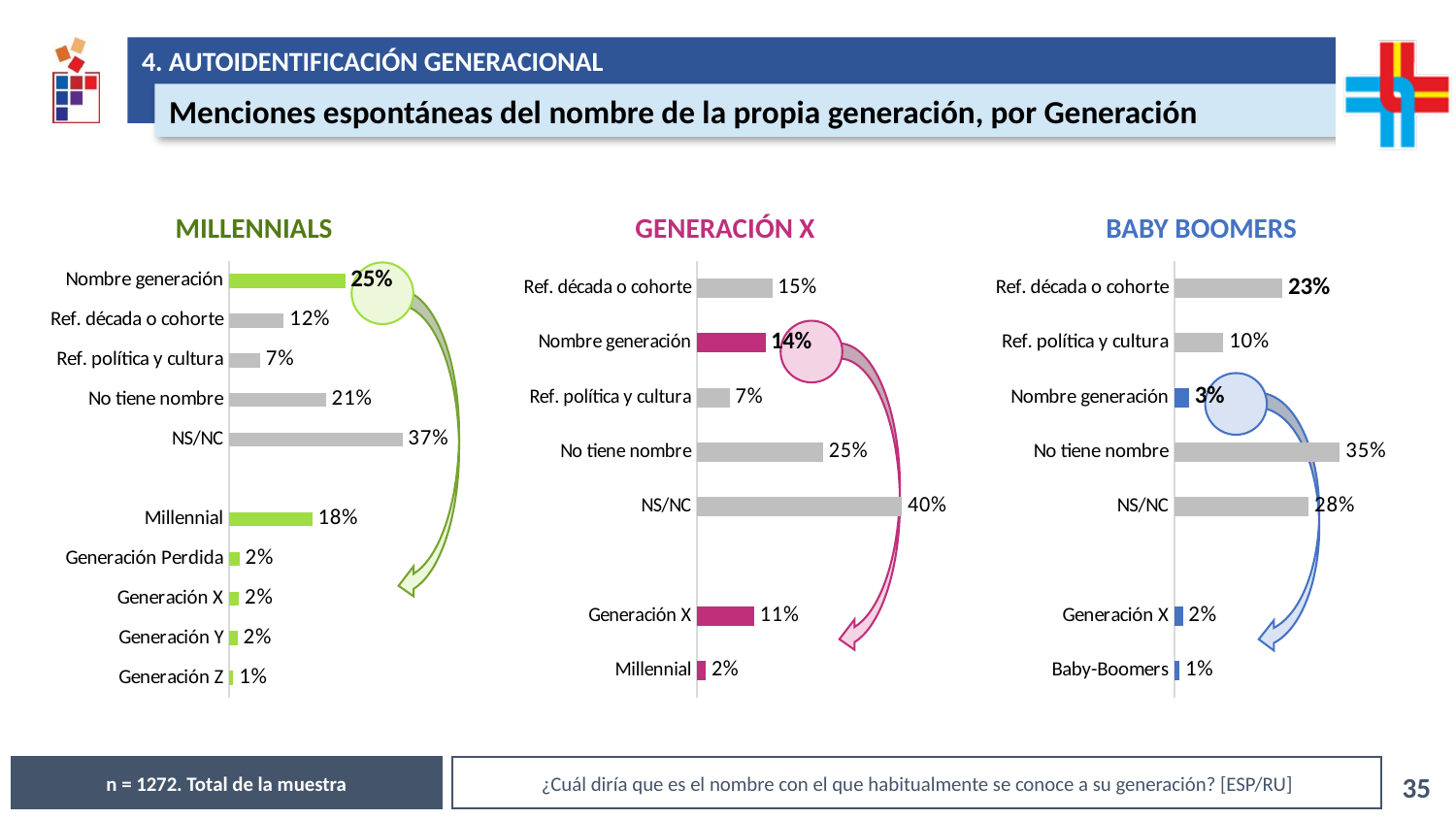
In the GENERACIÓN X chart, which category has the highest value? NS/NC In the MILLENNIALS chart, what is the value for Millennial? 18% In the BABY BOOMERS chart, what is the value for Nombre generación? 3% What type of chart is the GENERACIÓN X chart? Bar chart How many categories does the MILLENNIALS chart show? 10 In the BABY BOOMERS chart, which category has the lowest value? Baby-Boomers In the GENERACIÓN X chart, which is larger: Ref. década o cohorte or Nombre generación? Ref. década o cohorte How many categories does the BABY BOOMERS chart show? 7 In the MILLENNIALS chart, what is the value for NS/NC? 37% In the GENERACIÓN X chart, what is the value for Generación X? 11% In the MILLENNIALS chart, what is the difference between NS/NC and No tiene nombre? 16% In the BABY BOOMERS chart, what is the difference between No tiene nombre and NS/NC? 7%